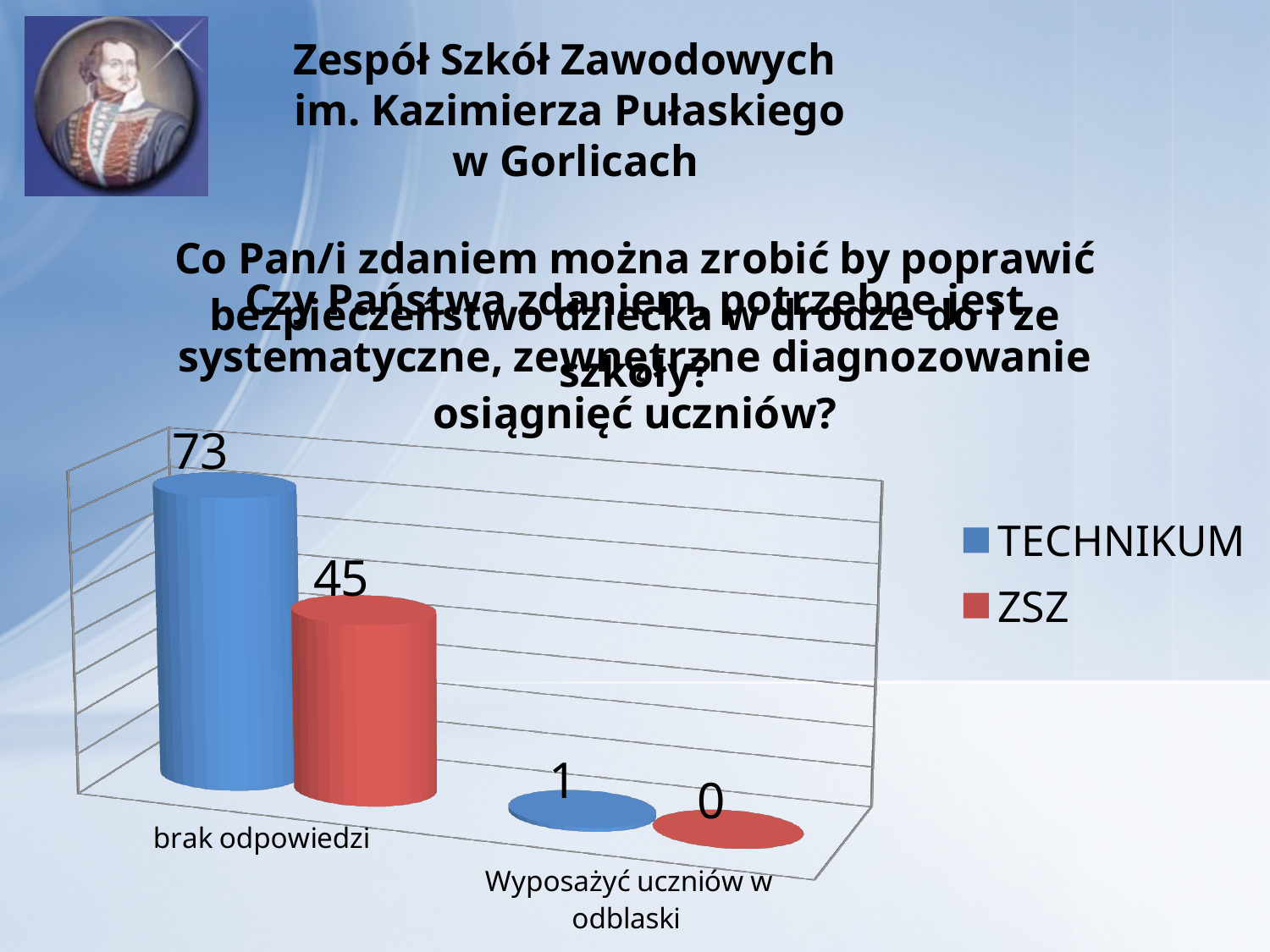
How many series does the chart legend list? 2 In the "brak odpowiedzi" category, which series has the larger value, TECHNIKUM or ZSZ? TECHNIKUM What is the value for TECHNIKUM in the "Wyposażyć uczniów w odblaski" category? 1 What is the value for ZSZ in the "brak odpowiedzi" category? 45 What is the value for TECHNIKUM in the "brak odpowiedzi" category? 73 What is the value for ZSZ in the "Wyposażyć uczniów w odblaski" category? 0 Which colour represents the ZSZ series in the chart? red How many categories are shown on the x axis of the chart? 2 Which category has the lowest value for ZSZ? Wyposażyć uczniów w odblaski What kind of chart is shown on the slide? bar chart Which category has the highest value for TECHNIKUM? brak odpowiedzi What is the difference between the TECHNIKUM and ZSZ values in the "brak odpowiedzi" category? 28